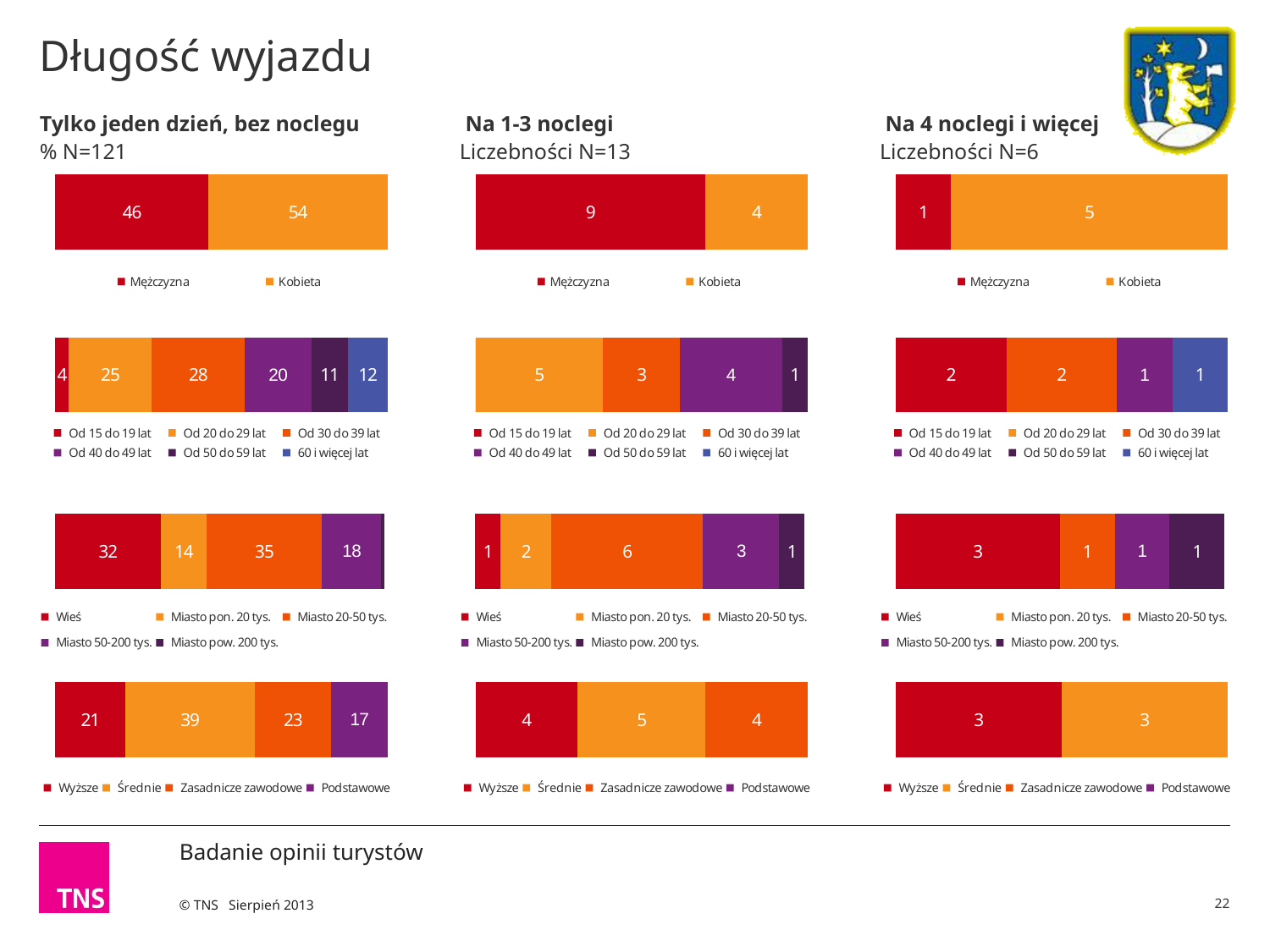
In the place-of-residence chart under "Na 1-3 noclegi", which category has the highest value? Miasto 20-50 tys. In the gender chart under "Tylko jeden dzień, bez noclegu", what is the value for Kobieta? 54 In the education chart under "Tylko jeden dzień, bez noclegu", what is the value for Średnie? 39 In the age chart under "Tylko jeden dzień, bez noclegu", which age group has the highest value? Od 30 do 39 lat In the age chart under "Tylko jeden dzień, bez noclegu", what is the value for Od 40 do 49 lat? 20 In the education chart under "Na 1-3 noclegi", what is the total of the stacked bar? 13 In the place-of-residence chart under "Tylko jeden dzień, bez noclegu", what is the value for Wieś? 32 In the gender chart under "Na 4 noclegi i więcej", which is larger, Mężczyzna or Kobieta? Kobieta How many series does the legend of the education chart under "Na 4 noclegi i więcej" list? 4 In the age chart under "Tylko jeden dzień, bez noclegu", what is the difference between Od 20 do 29 lat and Od 50 do 59 lat? 14 In the gender chart under "Na 1-3 noclegi", what is the value for Mężczyzna? 9 What kind of chart is the gender chart under "Na 1-3 noclegi"? Stacked bar chart